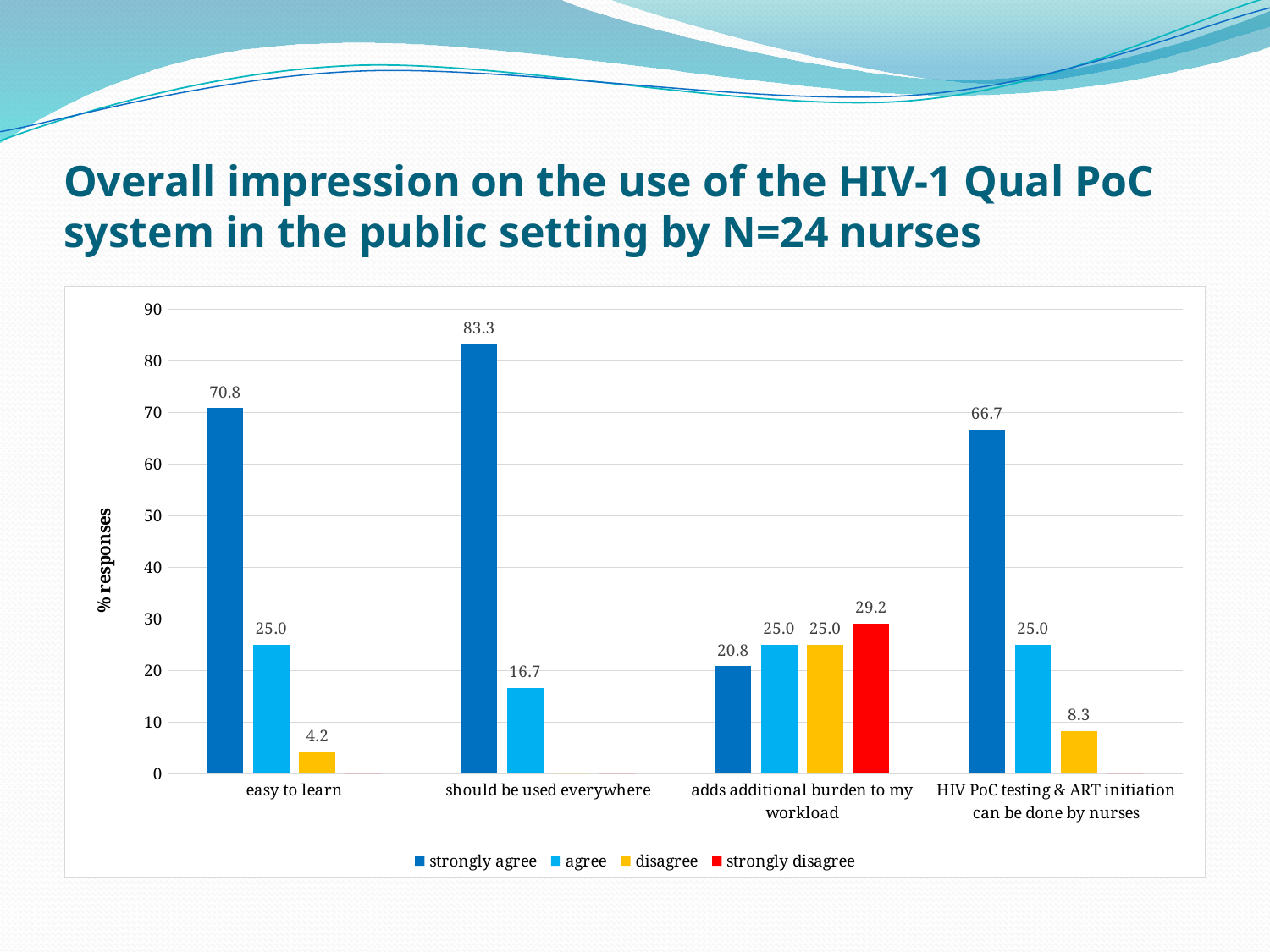
What is the 'strongly agree' value for 'easy to learn'? 70.8 What kind of chart is shown on the slide? bar chart What is the 'agree' value for 'should be used everywhere'? 16.7 What is the label of the y axis? % responses How many series does the legend list? 4 What is the 'disagree' value for 'HIV PoC testing & ART initiation can be done by nurses'? 8.3 Which is larger: the 'disagree' value for 'easy to learn' or the 'disagree' value for 'HIV PoC testing & ART initiation can be done by nurses'? HIV PoC testing & ART initiation can be done by nurses Which category has the highest 'strongly agree' value? should be used everywhere How many categories are shown on the x axis? 4 What is the 'strongly disagree' value for 'adds additional burden to my workload'? 29.2 What is the difference between the 'strongly agree' values for 'should be used everywhere' and 'easy to learn'? 12.5 Which category has the lowest 'strongly agree' value? adds additional burden to my workload